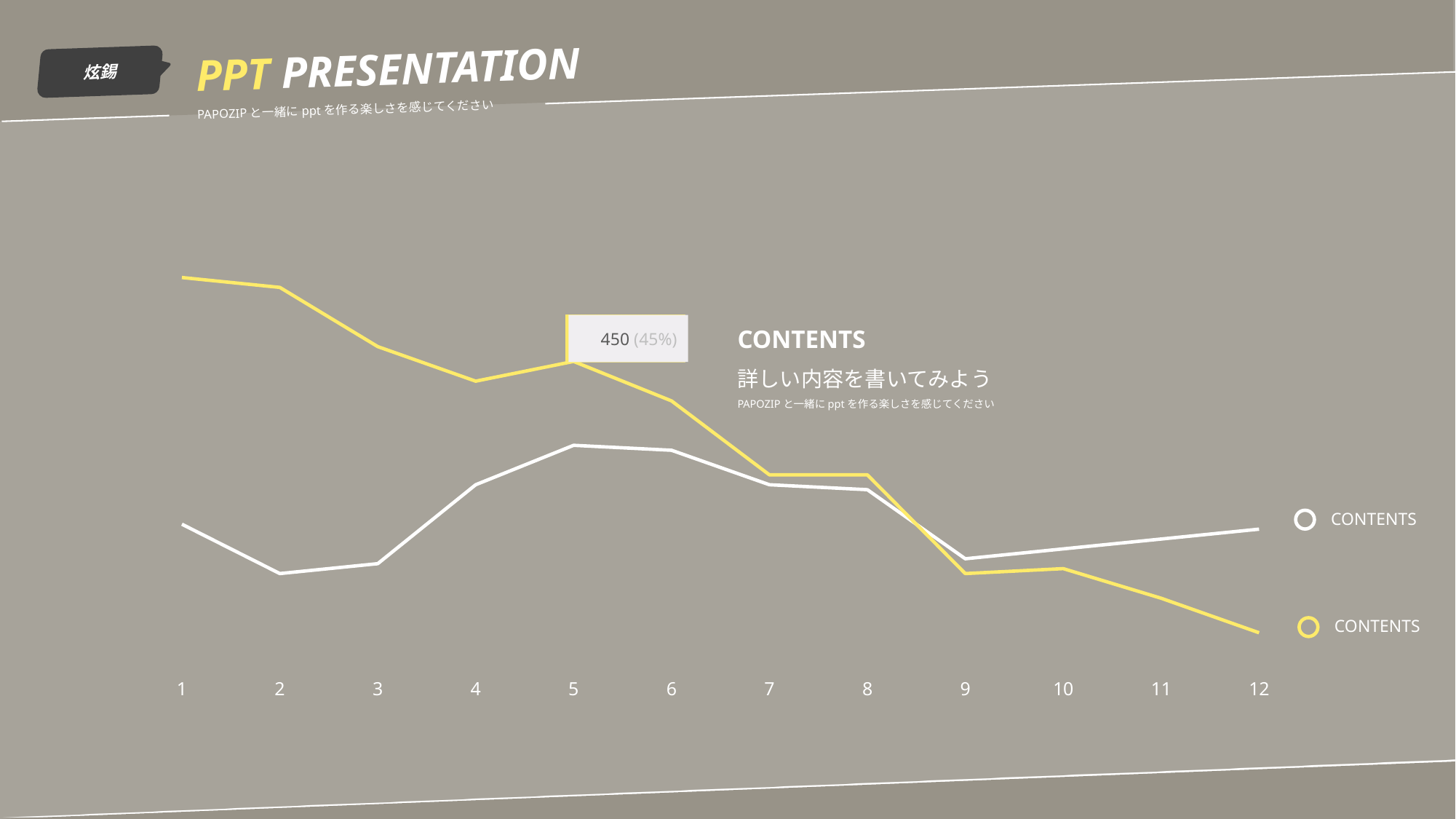
What text is used for both entries in the chart's legend? CONTENTS What value is labelled on the yellow line at x = 5? 450 (45%) Does the yellow line generally rise or fall from x = 1 to x = 12? fall At which x value is the yellow line at its highest? 1 At which x value is the yellow line at its lowest? 12 At x = 1, which line is higher, the yellow line or the white line? yellow line At which x value does the white line reach its highest point? 5 What kind of chart is shown on the slide? line chart At x = 12, which line is higher, the yellow line or the white line? white line Does the white line rise or fall from x = 9 to x = 12? rise How many series does the chart's legend list? 2 How many points are plotted along the x axis of the chart? 12